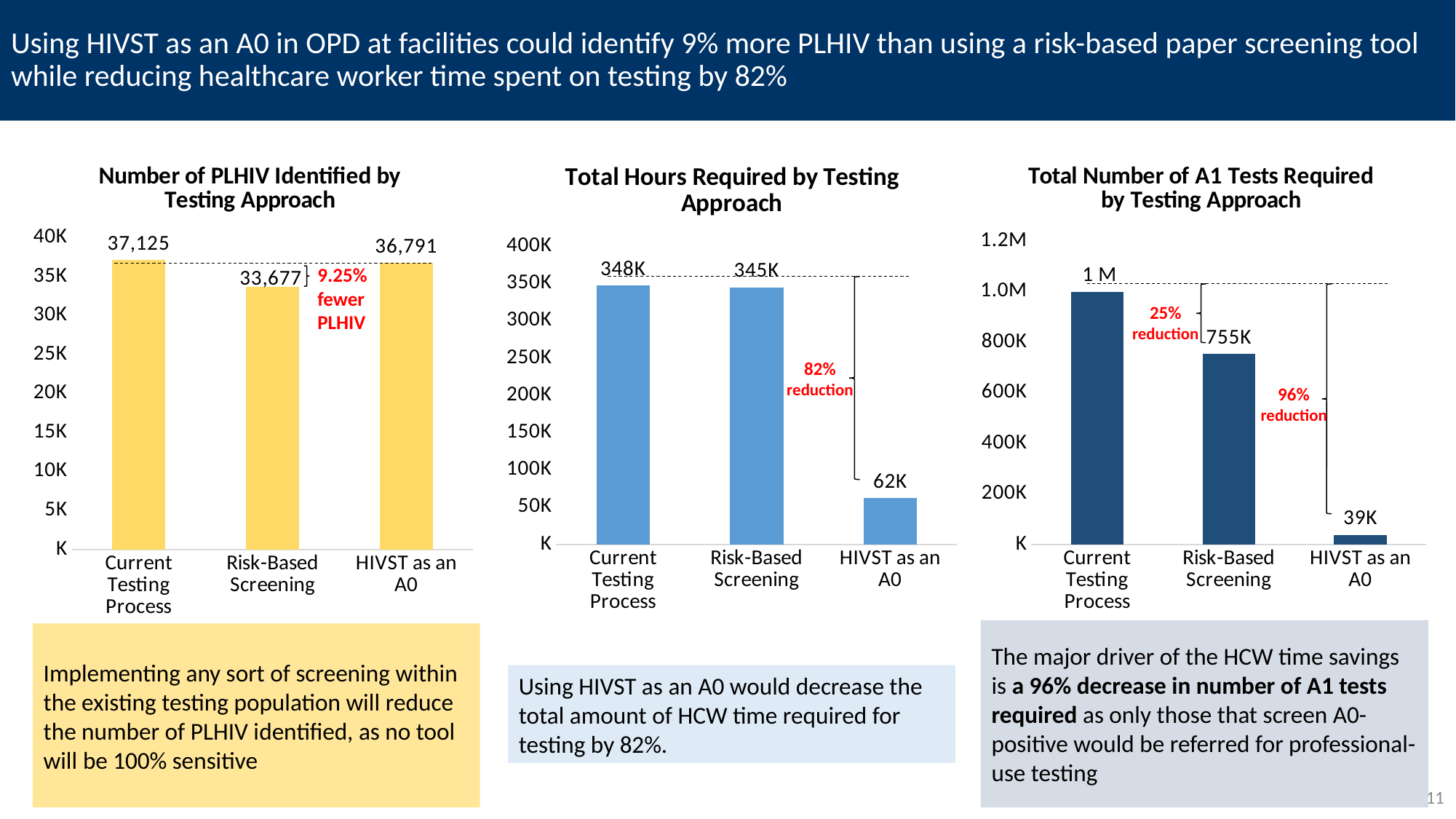
In the 'Number of PLHIV Identified by Testing Approach' chart, what is the value for Risk-Based Screening? 33,677 In the 'Total Hours Required by Testing Approach' chart, what is the difference between Current Testing Process and Risk-Based Screening? 2K In the 'Total Hours Required by Testing Approach' chart, what is the value for HIVST as an A0? 62K In the 'Total Hours Required by Testing Approach' chart, which category has the highest value? Current Testing Process In the 'Number of PLHIV Identified by Testing Approach' chart, what is the value for Current Testing Process? 37,125 In the 'Total Number of A1 Tests Required by Testing Approach' chart, is the value for Risk-Based Screening larger or smaller than the value for HIVST as an A0? larger In the 'Number of PLHIV Identified by Testing Approach' chart, which category has the lowest value? Risk-Based Screening What kind of chart is the 'Total Number of A1 Tests Required by Testing Approach' chart? bar chart In the 'Number of PLHIV Identified by Testing Approach' chart, what is the difference between Current Testing Process and HIVST as an A0? 334 In the 'Total Number of A1 Tests Required by Testing Approach' chart, what is the value for Risk-Based Screening? 755K How many categories are shown in the 'Total Hours Required by Testing Approach' chart? 3 In the 'Total Number of A1 Tests Required by Testing Approach' chart, which category has the lowest value? HIVST as an A0